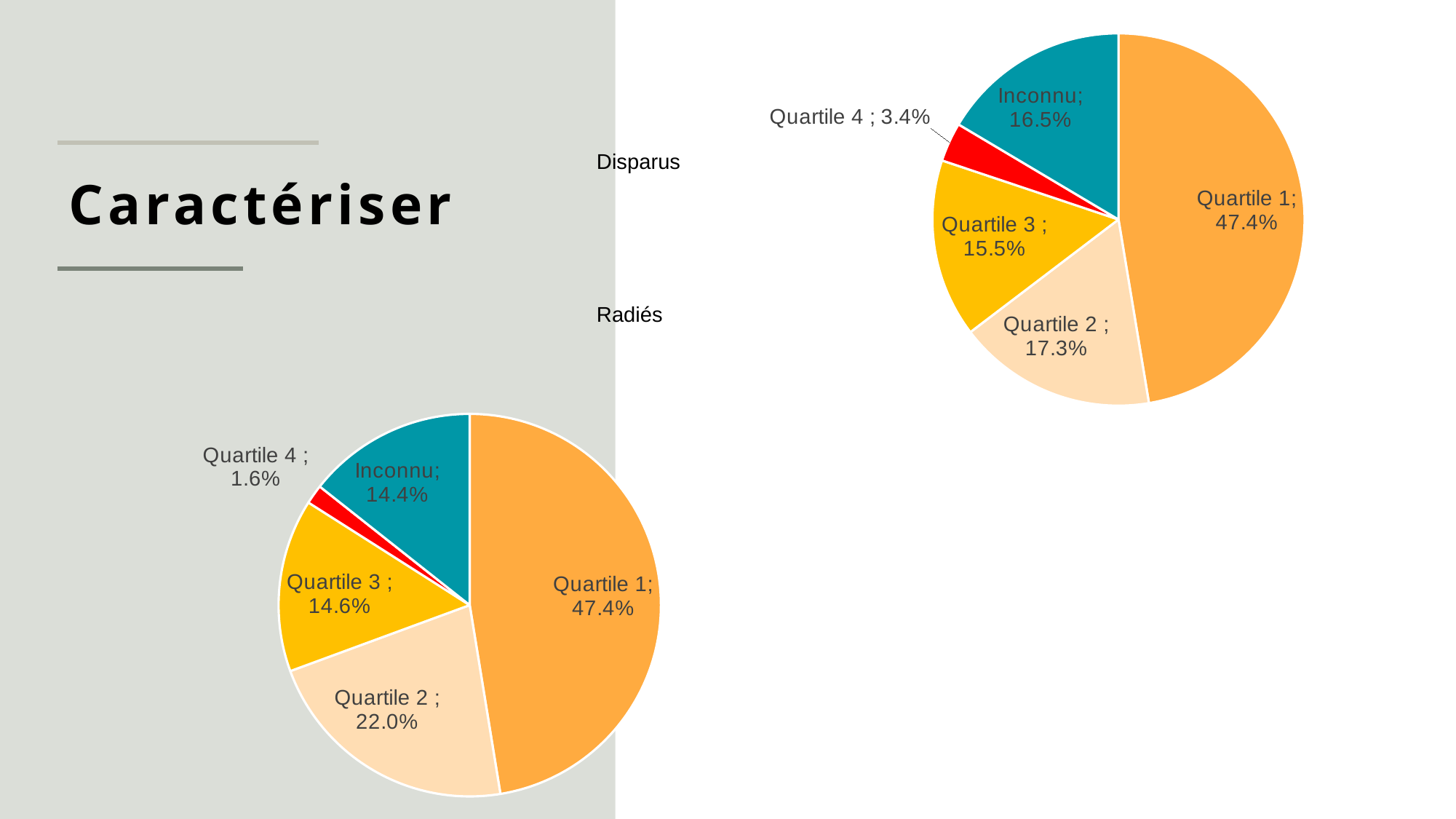
In the pie chart at the bottom left of the slide, which is larger, Quartile 3 or Inconnu? Quartile 3 In the pie chart at the top right of the slide, which category has the largest slice? Quartile 1 In the pie chart at the bottom left of the slide, what is the value for Quartile 4? 1.6% In the pie chart at the top right of the slide, what is the value for Quartile 2? 17.3% In the pie chart at the bottom left of the slide, what is the value for Quartile 2? 22.0% In the pie chart at the top right of the slide, which category has the smallest slice? Quartile 4 In the pie chart at the top right of the slide, what colour is the Quartile 4 slice? Red In the pie chart at the top right of the slide, what is the difference between Quartile 2 and Quartile 3? 1.8% In the pie chart at the bottom left of the slide, what is the difference between Quartile 1 and Quartile 2? 25.4% How many slices does the pie chart at the bottom left of the slide have? 5 In the pie chart at the top right of the slide, what is the value for Inconnu? 16.5% What type of chart is shown at the top right of the slide? Pie chart